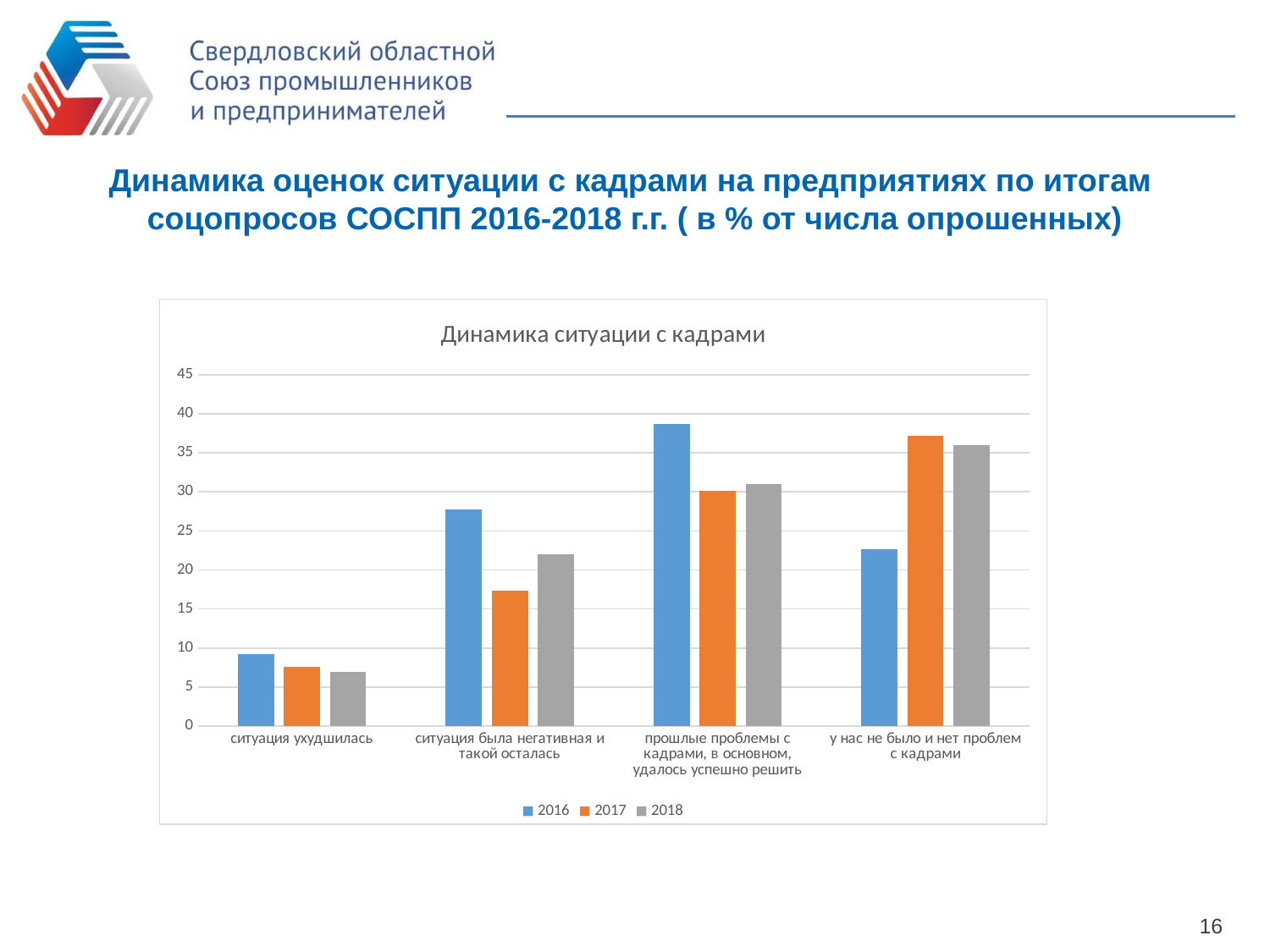
What is the title of the chart? Динамика ситуации с кадрами Is the 2016 value for "ситуация ухудшилась" greater or less than 10? less Which years are listed in the chart legend? 2016, 2017, 2018 How many categories are shown on the x axis of the chart? 4 Which category has the lowest value for the 2018 series? ситуация ухудшилась Is the 2018 value for "у нас не было и нет проблем с кадрами" greater or less than 30? greater What kind of chart is shown on the slide? Bar chart Which category has the highest value for the 2016 series? прошлые проблемы с кадрами, в основном, удалось успешно решить Is the 2017 value for "ситуация была негативная и такой осталась" greater or less than 20? less For "ситуация была негативная и такой осталась", which is larger: the 2016 value or the 2017 value? 2016 How many series does the chart legend list? 3